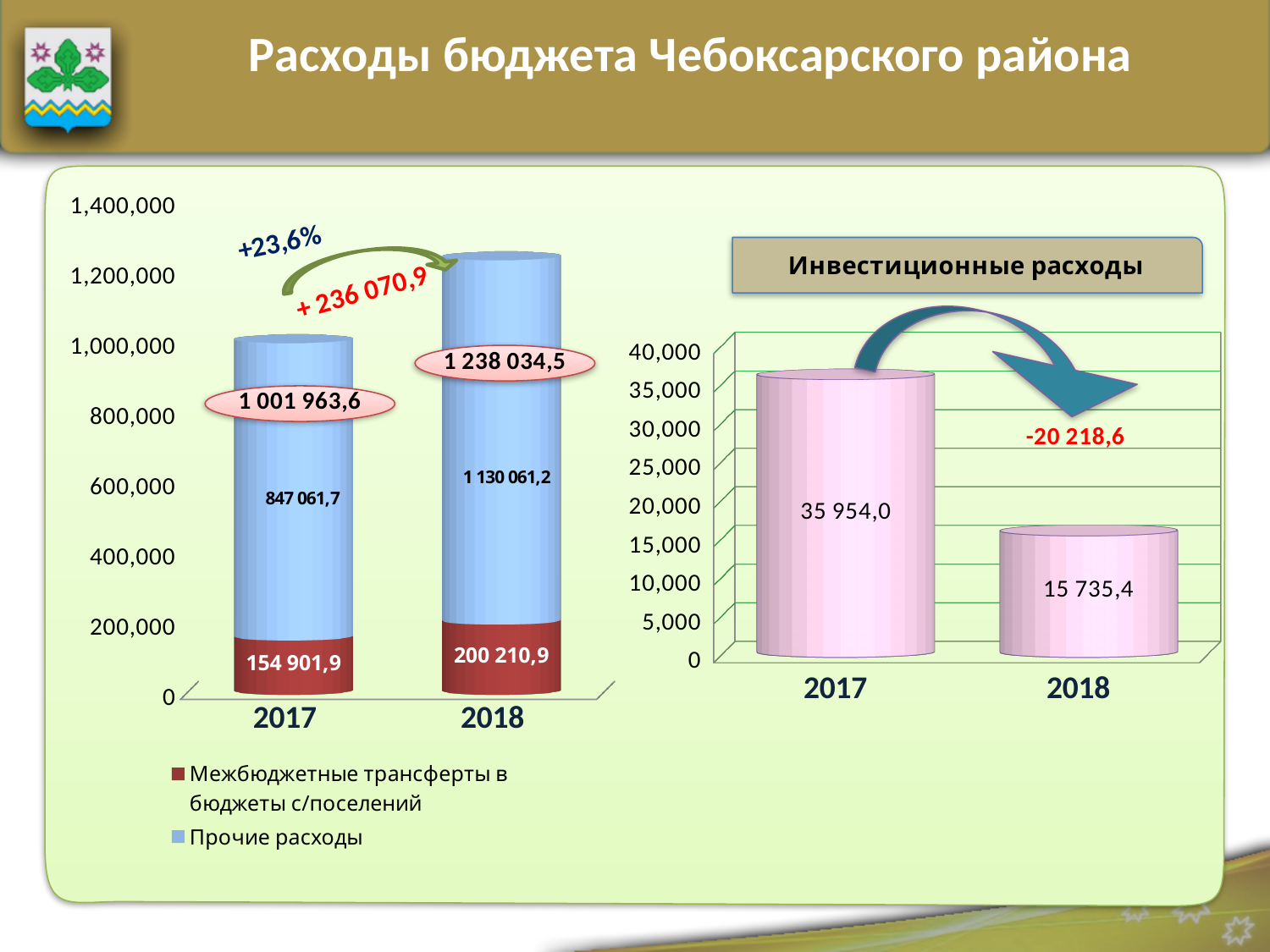
In the chart titled Инвестиционные расходы, by how much does the 2018 value differ from the 2017 value? 20 218,6 In the chart titled Инвестиционные расходы, do the values rise or fall from 2017 to 2018? fall In the left stacked bar chart, what is the value of Прочие расходы for 2017? 847 061,7 In the left stacked bar chart, what is the value of Межбюджетные трансферты в бюджеты с/поселений for 2018? 200 210,9 In the chart titled Инвестиционные расходы, what is the value for 2018? 15 735,4 In the left stacked bar chart, what is the difference between the 2018 total and the 2017 total? 236 070,9 In the left stacked bar chart, what is the total of the 2018 bar? 1 238 034,5 How many series does the legend of the left stacked bar chart list? 2 In the chart titled Инвестиционные расходы, which year has the higher value? 2017 In the left stacked bar chart, what is the total of the 2017 bar? 1 001 963,6 What percentage change is labelled above the bars in the left stacked bar chart? +23,6% In the chart titled Инвестиционные расходы, what is the value for 2017? 35 954,0